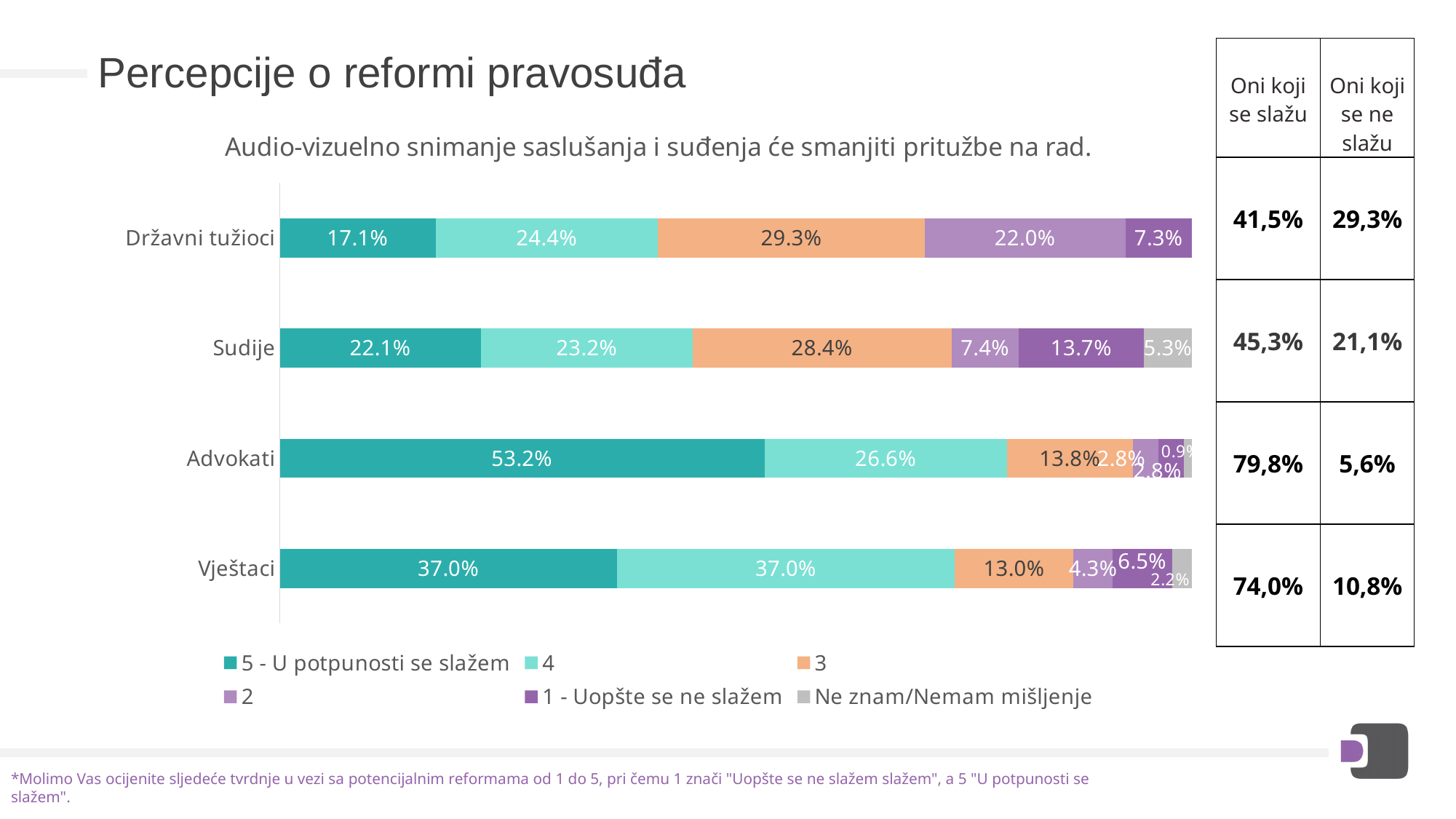
What kind of chart is shown on the slide? Stacked bar chart What is the difference between the "5 - U potpunosti se slažem" values for Sudije and Državni tužioci? 5.0% What is the value for Advokati in the series "5 - U potpunosti se slažem"? 53.2% Which category has the highest value in the series "5 - U potpunosti se slažem"? Advokati What is the value for Vještaci in the series "4"? 37.0% What is the value for Državni tužioci in the series "5 - U potpunosti se slažem"? 17.1% How many series does the legend list? 6 How many categories are shown on the chart? 4 What is the value for Sudije in the series "3"? 28.4% What is the value for Sudije in the series "1 - Uopšte se ne slažem"? 13.7% Which has the larger value in the series "3": Državni tužioci or Sudije? Državni tužioci Which category has the lowest value in the series "5 - U potpunosti se slažem"? Državni tužioci